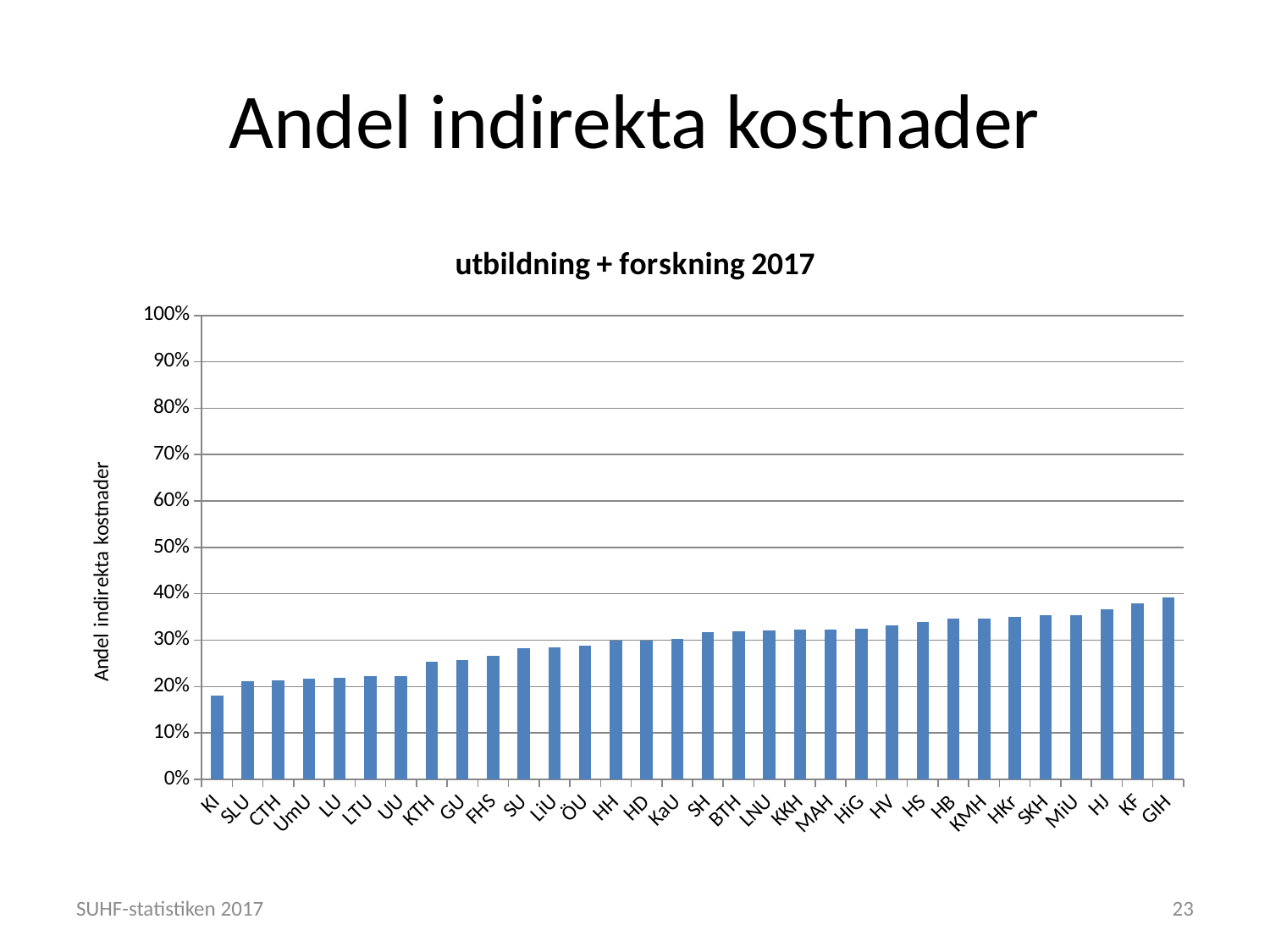
Is the value for KI greater or less than 20%? less What kind of chart is shown on the slide? bar chart Is the value for KTH greater or less than 20%? greater Is the value for HV greater or less than 30%? greater Which institution has the lowest share of indirect costs in the chart? KI What is the label on the vertical axis of the chart? Andel indirekta kostnader What is the title of the chart? utbildning + forskning 2017 Which has the larger value, KTH or HJ? HJ Do the values rise or fall from left to right along the x axis? rise How many institutions (bars) are shown in the chart? 32 Which institution has the highest share of indirect costs in the chart? GIH